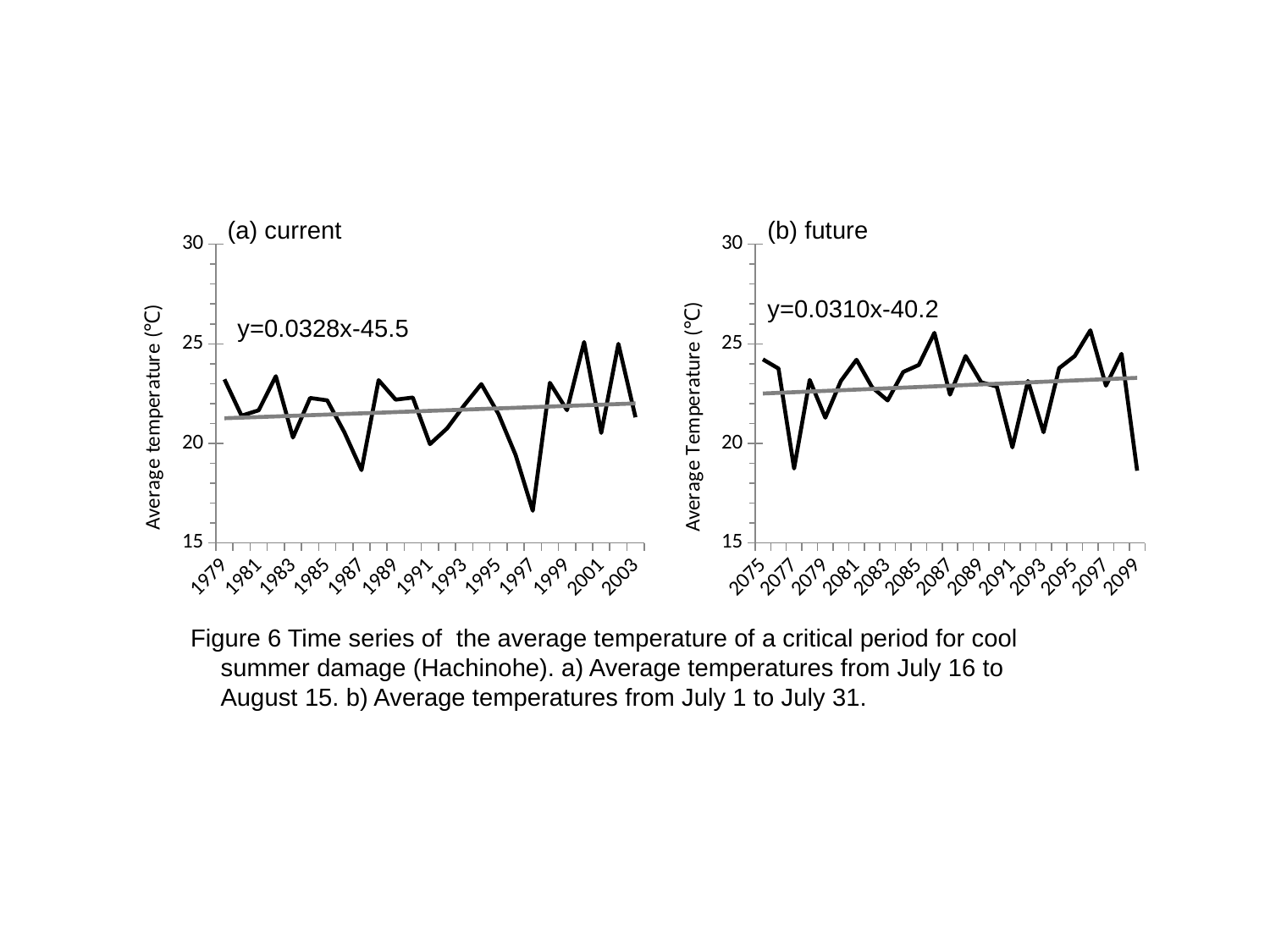
In chart (a) current, is the value for 1997 greater or less than 20? less In chart (b) future, is the value for 2099 greater or less than 20? less In chart (b) future, does the grey trend line rise or fall across the years? rise What trend-line equation is printed on chart (b) future? y=0.0310x-40.2 In chart (b) future, is the value for 2077 greater or less than 20? less In chart (a) current, does the grey trend line rise or fall from 1979 to 2003? rise What trend-line equation is printed on chart (a) current? y=0.0328x-45.5 How many charts are shown on the slide? 2 What kind of chart is chart (a) current? line chart In chart (a) current, which year has the lowest average temperature? 1997